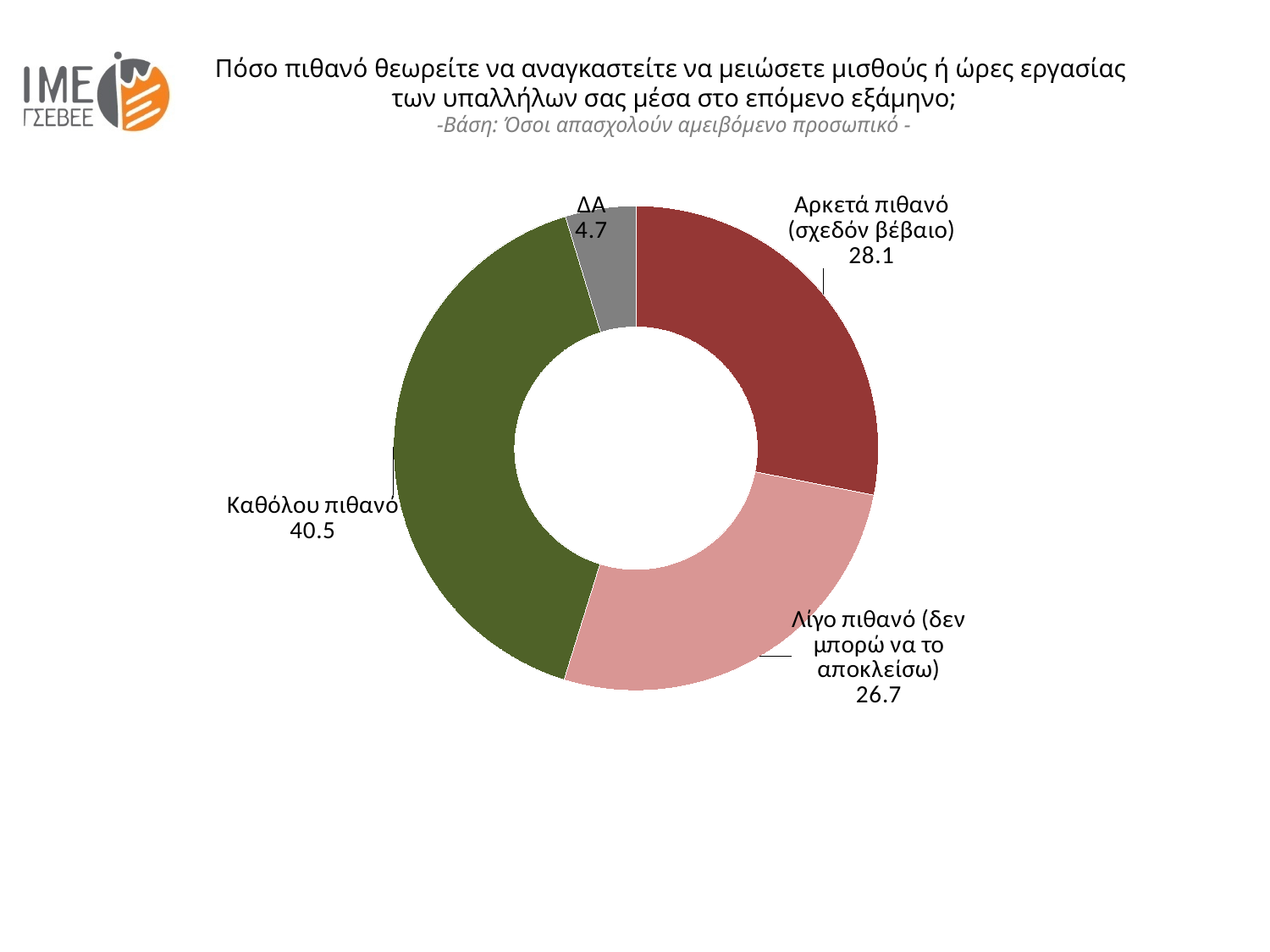
Which is larger, the value for 'Καθόλου πιθανό' or the value for 'Λίγο πιθανό (δεν μπορώ να το αποκλείσω)'? Καθόλου πιθανό Which category has the smallest slice? ΔΑ What value is shown for the 'Καθόλου πιθανό' slice? 40.5 What value is shown for the 'Αρκετά πιθανό (σχεδόν βέβαιο)' slice? 28.1 What value is shown for the 'Λίγο πιθανό (δεν μπορώ να το αποκλείσω)' slice? 26.7 What kind of chart is shown on the slide? doughnut chart How many categories (slices) does the chart show? 4 What colour is the 'ΔΑ' slice? grey Which category has the largest slice? Καθόλου πιθανό What is the difference between the values for 'Καθόλου πιθανό' and 'Αρκετά πιθανό (σχεδόν βέβαιο)'? 12.4 What is the difference between the values for 'Αρκετά πιθανό (σχεδόν βέβαιο)' and 'Λίγο πιθανό (δεν μπορώ να το αποκλείσω)'? 1.4 What value is shown for the 'ΔΑ' slice? 4.7